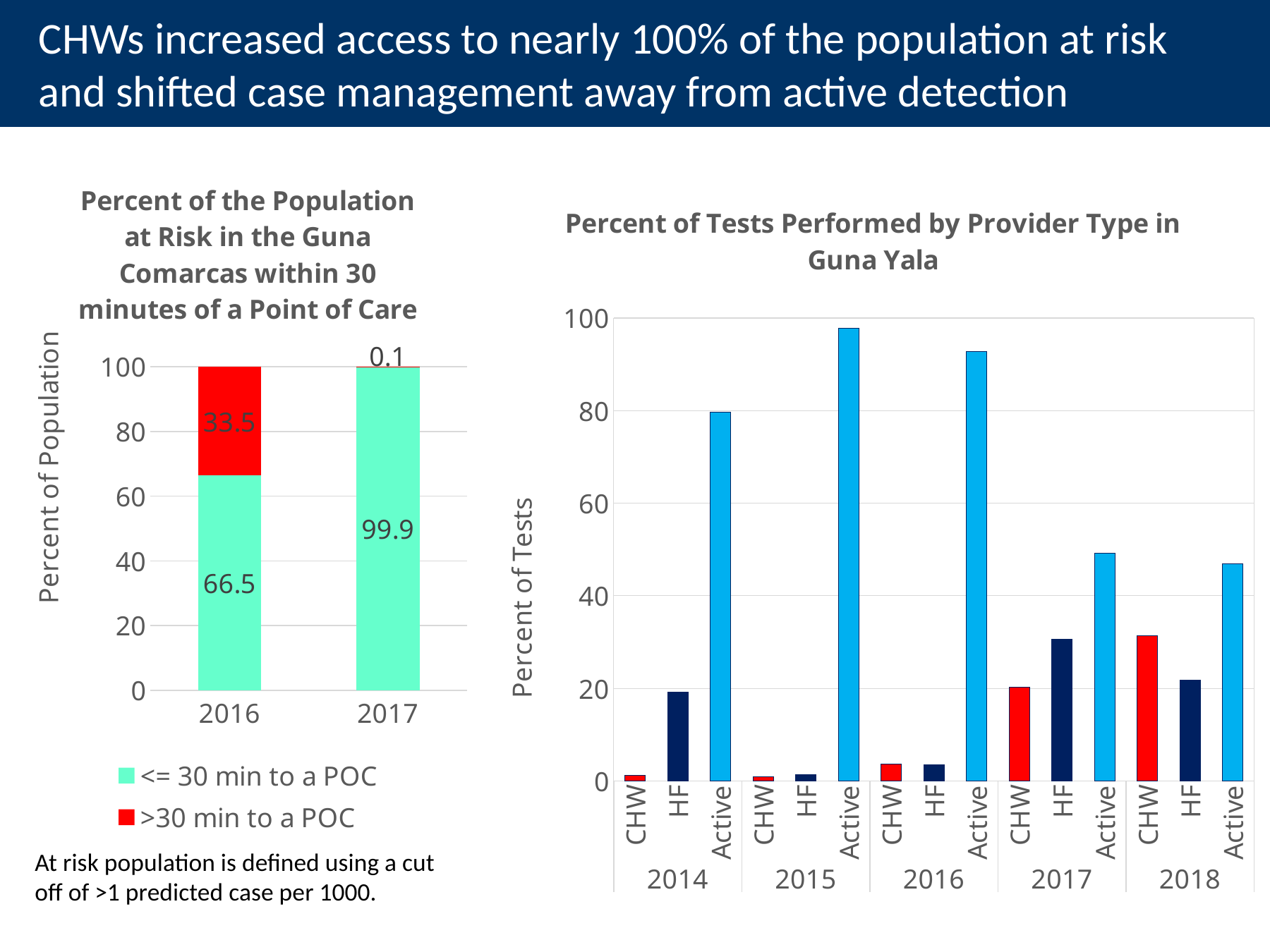
In the chart 'Percent of Tests Performed by Provider Type in Guna Yala', is the value for CHW in 2018 greater or less than 20? greater In the chart 'Percent of Tests Performed by Provider Type in Guna Yala', which bar is the highest overall? Active in 2015 In the chart 'Percent of the Population at Risk in the Guna Comarcas within 30 minutes of a Point of Care', by how much did the '<= 30 min to a POC' value increase from 2016 to 2017? 33.4 In the chart 'Percent of Tests Performed by Provider Type in Guna Yala', is the value for Active in 2017 greater or less than 60? less In the chart 'Percent of the Population at Risk in the Guna Comarcas within 30 minutes of a Point of Care', what is the value for '<= 30 min to a POC' in 2017? 99.9 How many series does the legend of the left chart list? 2 In the chart 'Percent of the Population at Risk in the Guna Comarcas within 30 minutes of a Point of Care', what is the value for '>30 min to a POC' in 2017? 0.1 In the chart 'Percent of the Population at Risk in the Guna Comarcas within 30 minutes of a Point of Care', what is the value for '<= 30 min to a POC' in 2016? 66.5 What kind of chart is 'Percent of Tests Performed by Provider Type in Guna Yala'? Bar chart In the chart 'Percent of Tests Performed by Provider Type in Guna Yala', how many years are shown on the x axis? 5 In the chart 'Percent of the Population at Risk in the Guna Comarcas within 30 minutes of a Point of Care', what is the value for '>30 min to a POC' in 2016? 33.5 In the chart 'Percent of the Population at Risk in the Guna Comarcas within 30 minutes of a Point of Care', what is the total of the stacked bar for 2016? 100